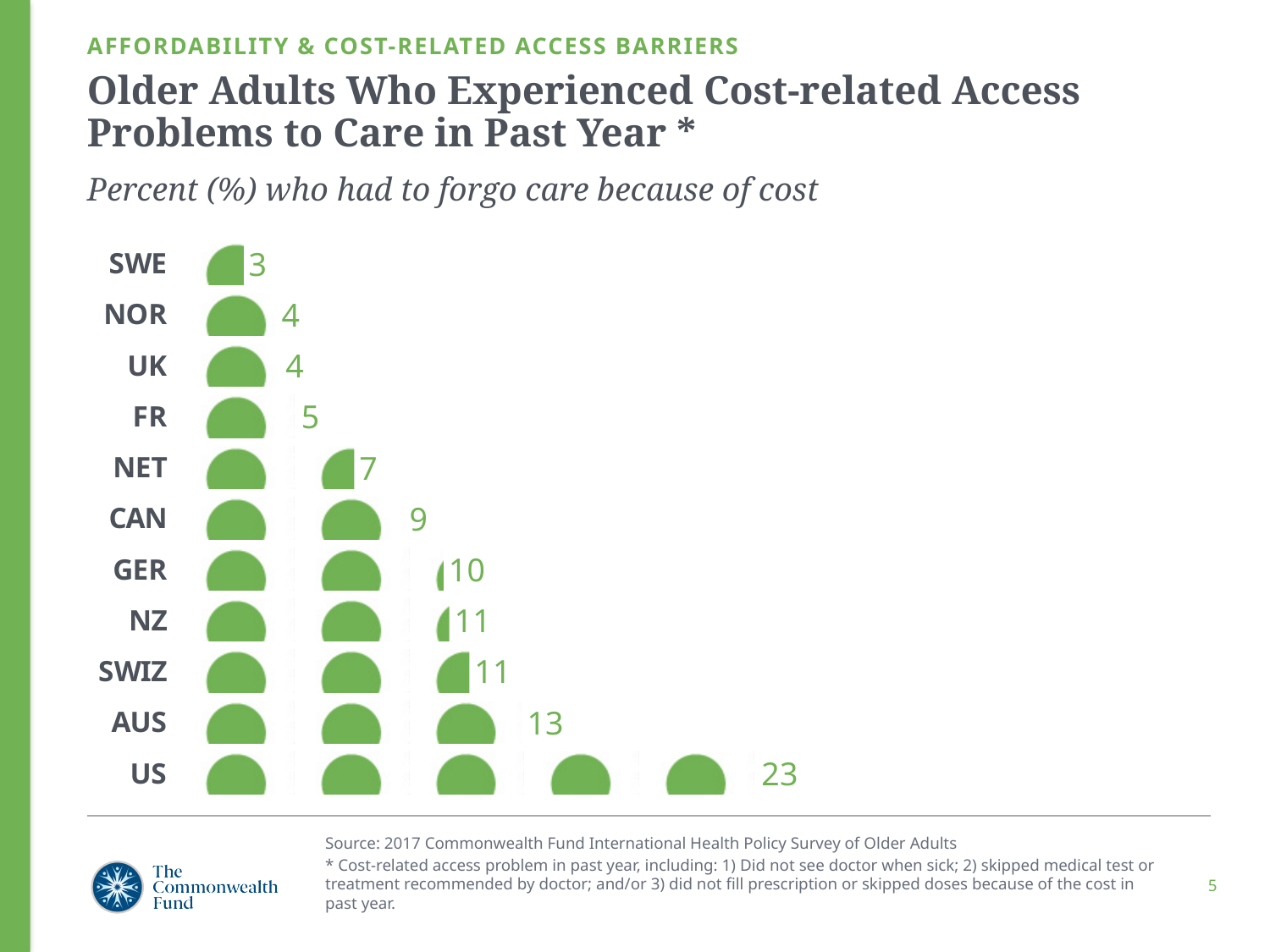
What is the difference between the values for the US and AUS? 10 What is the value for CAN? 9 What is the value for SWE? 3 Which country has the lowest value? SWE What kind of chart is this? bar chart What is the subtitle of the chart? Percent (%) who had to forgo care because of cost What is the value for the US? 23 Which country has the highest value? US Which is larger, the value for NET or the value for NZ? NZ What is the difference between the values for GER and FR? 5 What is the value for AUS? 13 How many countries are shown in the chart? 11